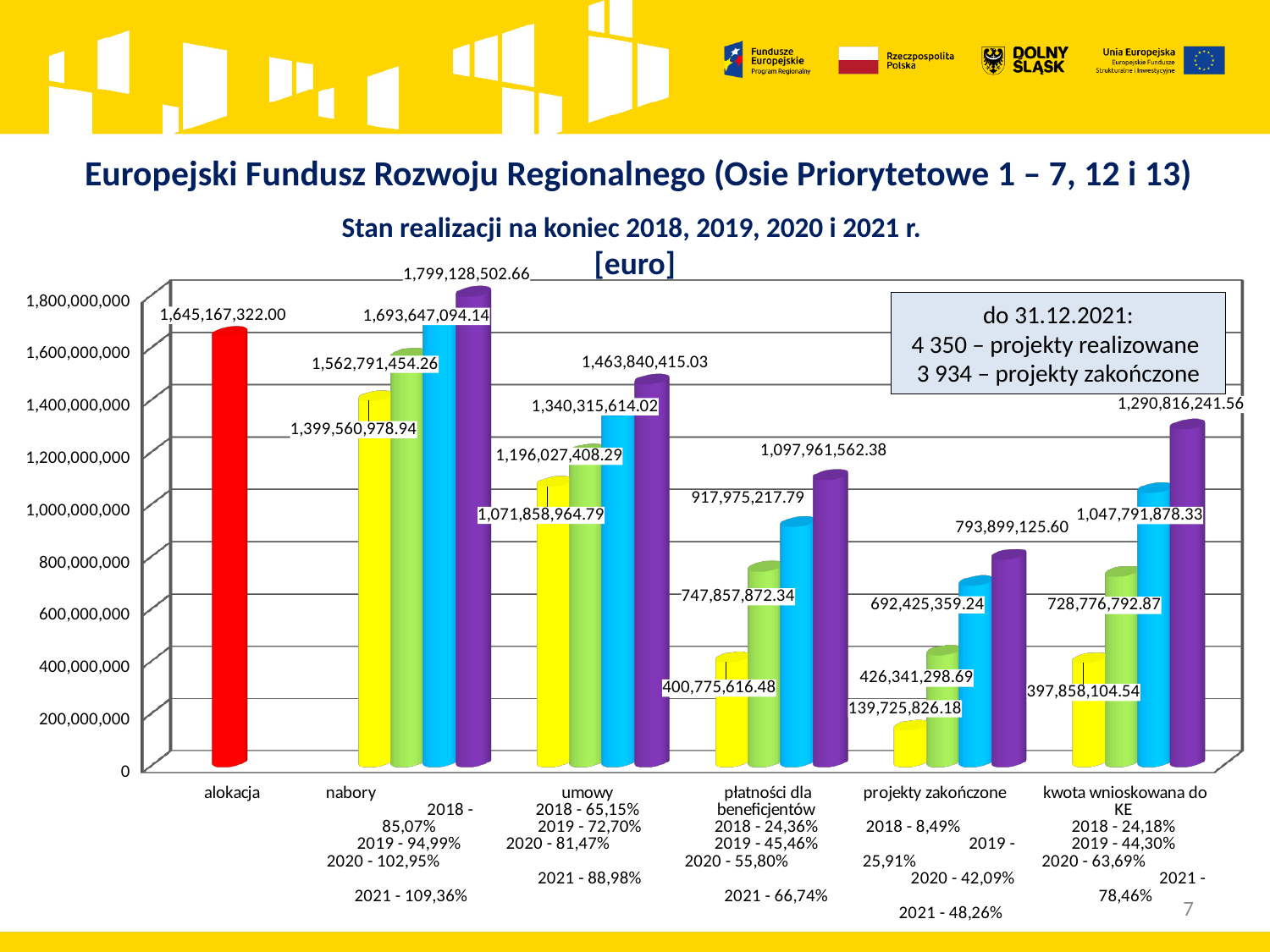
Which category contains the tallest bar on the chart? nabory How much larger is the 2021 nabory value than the alokacja value? 153,961,180.66 Is the 2020 value for płatności dla beneficjentów greater or less than 1,000,000,000? less Which bar is the lowest on the chart? 2018 bar for projekty zakończone (139,725,826.18) What is the value of the 2021 (purple) bar for nabory? 1,799,128,502.66 What is the value of the 2020 (blue) bar for kwota wnioskowana do KE? 1,047,791,878.33 What is the value of the 2018 (yellow) bar for projekty zakończone? 139,725,826.18 What is the value of the alokacja bar? 1,645,167,322.00 Do the bars for płatności dla beneficjentów rise or fall from 2018 to 2021? rise How many categories are shown on the x axis? 6 What is the difference between the 2021 and 2020 values for kwota wnioskowana do KE? 243,024,363.23 Which is larger: the 2021 value for umowy or the 2021 value for płatności dla beneficjentów? umowy